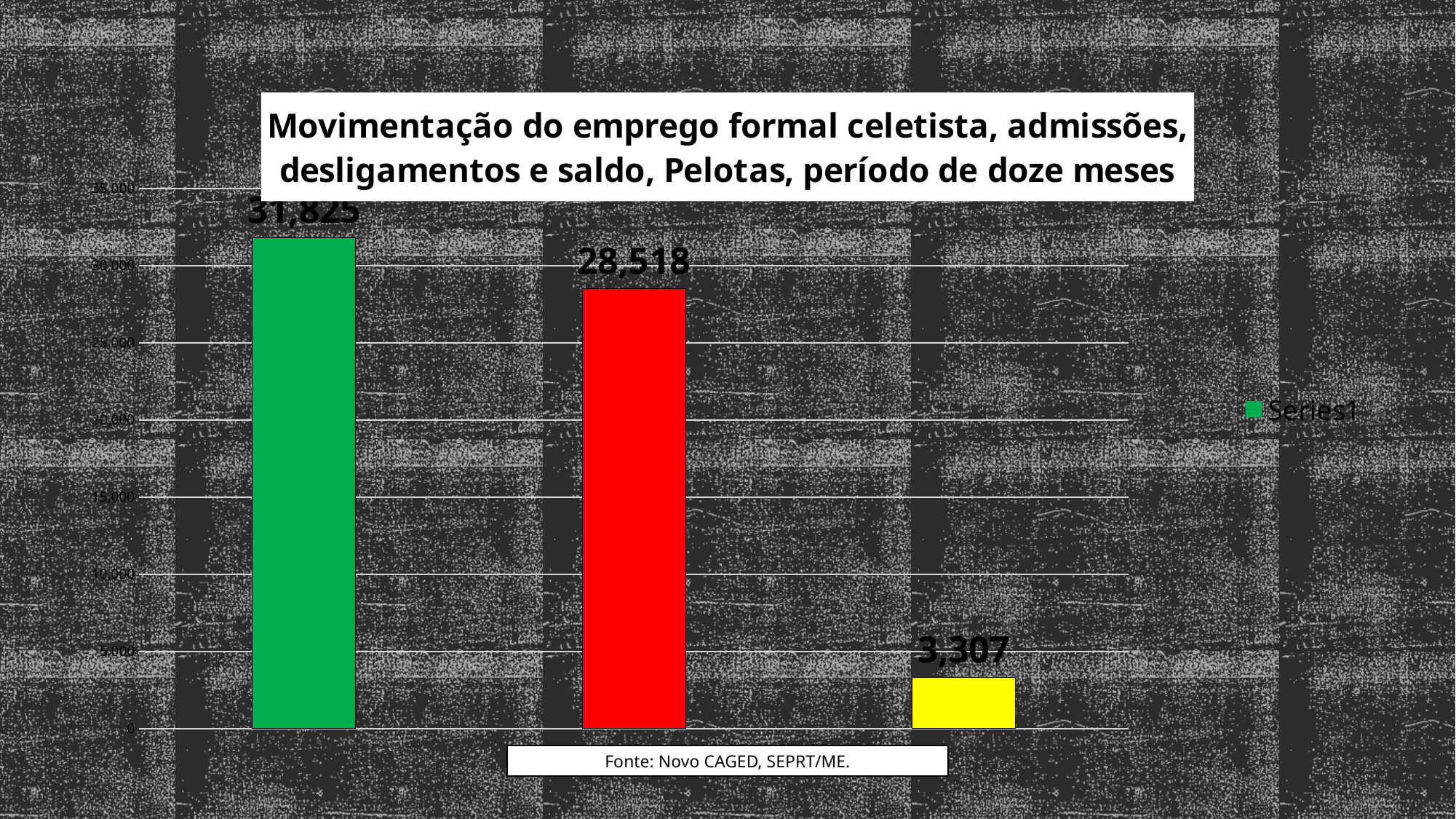
What is the source cited below the chart? Fonte: Novo CAGED, SEPRT/ME. Is the value of the red bar greater or less than 25,000? greater Which bar has the highest value? The green bar (31,825) Which is larger, the red bar or the yellow bar? The red bar Which bar has the lowest value? The yellow bar (3,307) How many bars are plotted in the chart? 3 What is the value shown on the yellow bar? 3,307 What kind of chart is shown on the slide? Bar chart What is the value shown on the green bar? 31,825 What is the value shown on the red bar? 28,518 How many series does the legend list? 1 What is the difference between the green bar and the red bar? 3,307